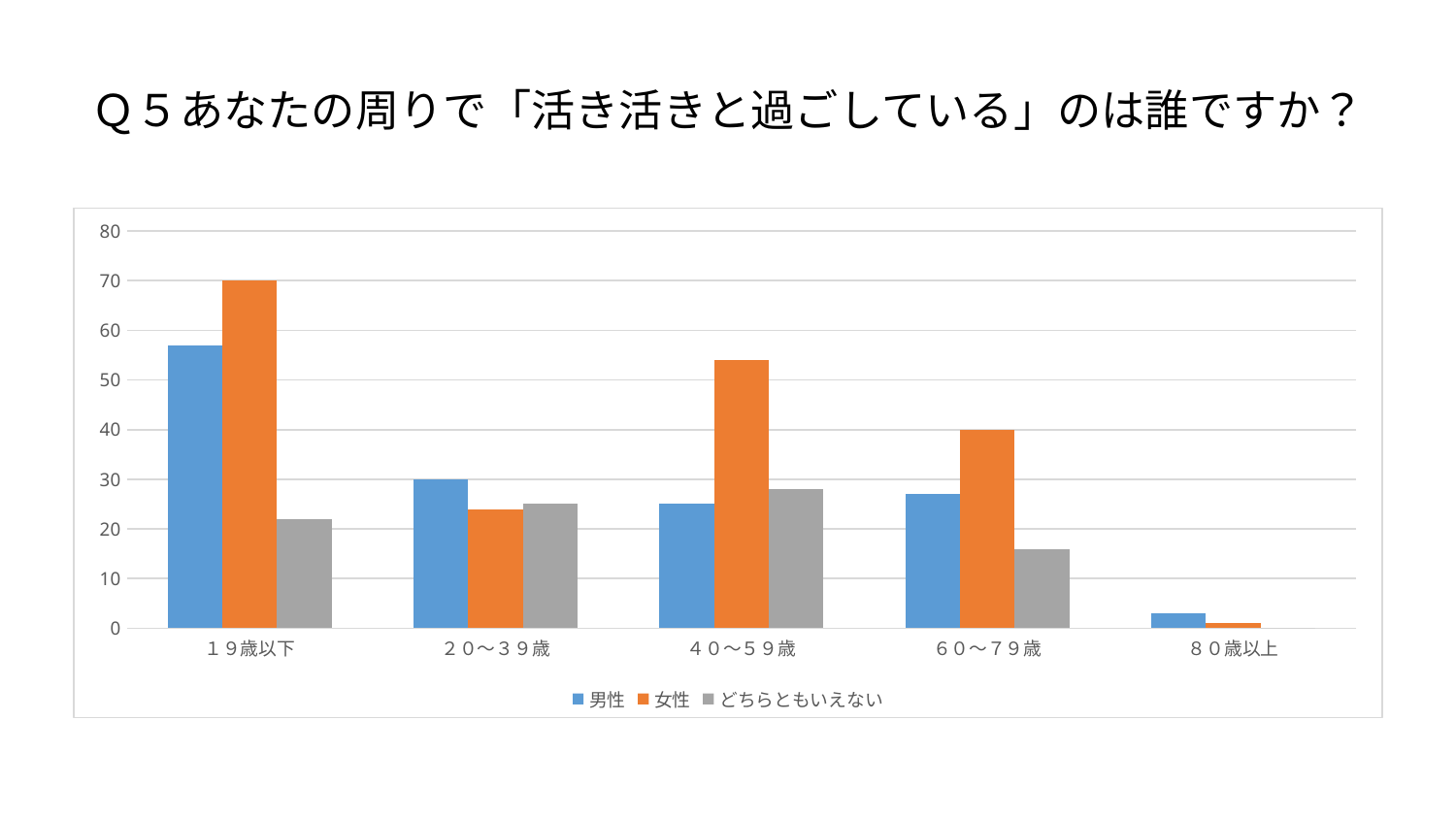
Is the value for どちらともいえない in the ６０〜７９歳 category greater or less than 20? less What is the value for 女性 in the １９歳以下 category? 70 How many series does the legend list? 3 Is the value for 男性 in the ８０歳以上 category greater or less than 10? less What is the value for 女性 in the ６０〜７９歳 category? 40 What are the three series listed in the legend? 男性, 女性, どちらともいえない Is the value for 男性 in the １９歳以下 category greater or less than 50? greater How many age categories are shown on the x axis? 5 In the ４０〜５９歳 category, which is larger, 男性 or 女性? 女性 What is the value for 男性 in the ２０〜３９歳 category? 30 What kind of chart is shown on the slide? bar chart In which age category is the 女性 bar the highest? １９歳以下